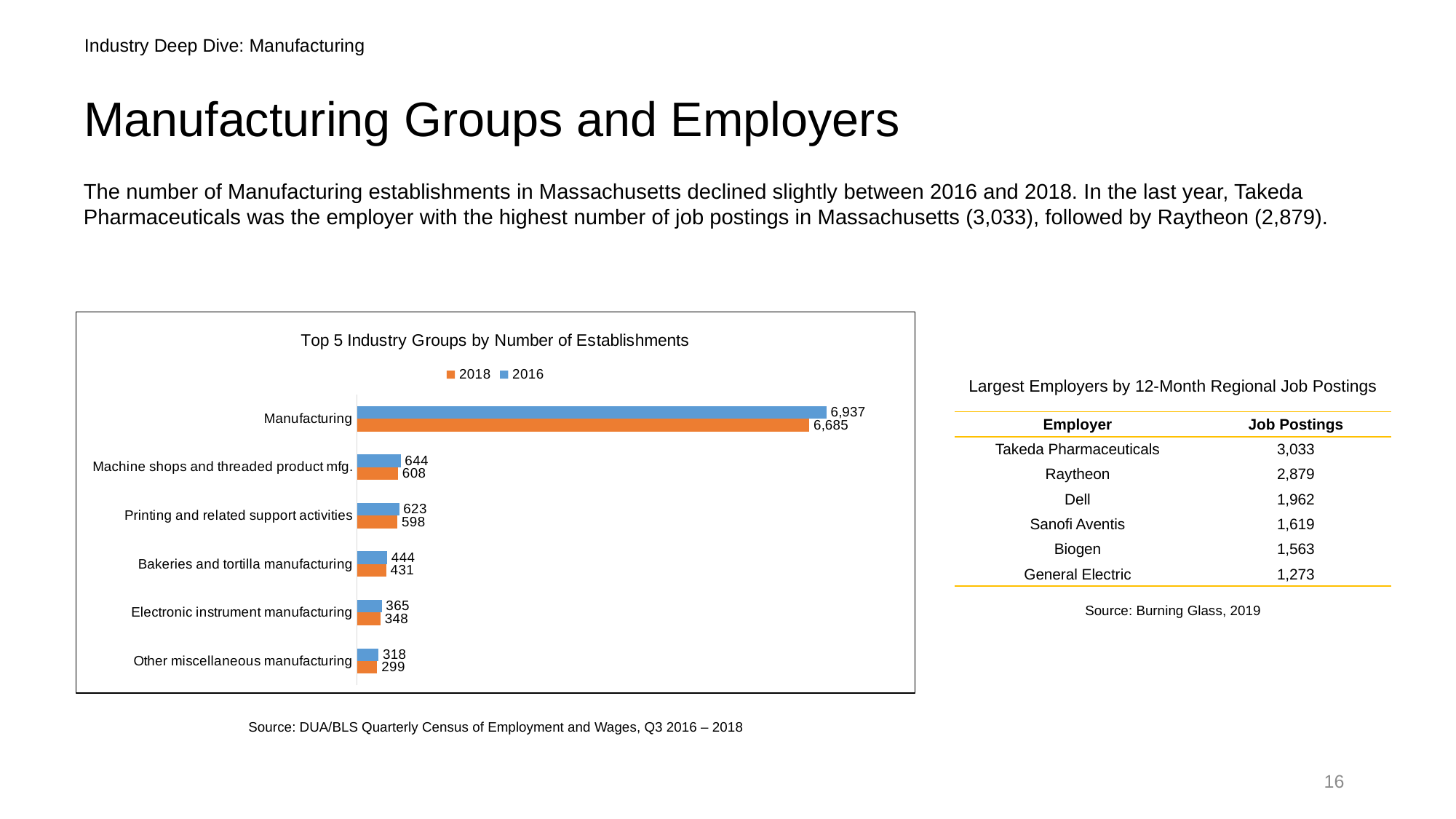
How many categories are shown in the 'Top 5 Industry Groups by Number of Establishments' chart? 6 What kind of chart is 'Top 5 Industry Groups by Number of Establishments'? bar chart In the 'Top 5 Industry Groups by Number of Establishments' chart, what is the 2016 value for Printing and related support activities? 623 In the 'Top 5 Industry Groups by Number of Establishments' chart, what is the 2018 value for Bakeries and tortilla manufacturing? 431 In the 'Top 5 Industry Groups by Number of Establishments' chart, which category has the highest 2016 value? Manufacturing In the 'Top 5 Industry Groups by Number of Establishments' chart, which colour represents the 2018 series? orange In the 'Top 5 Industry Groups by Number of Establishments' chart, is the 2016 value for Electronic instrument manufacturing larger or smaller than its 2018 value? larger In the 'Top 5 Industry Groups by Number of Establishments' chart, which category has the lowest 2018 value? Other miscellaneous manufacturing In the 'Top 5 Industry Groups by Number of Establishments' chart, what is the 2018 value for Manufacturing? 6,685 In the 'Top 5 Industry Groups by Number of Establishments' chart, what is the difference between the 2016 and 2018 values for Manufacturing? 252 In the 'Top 5 Industry Groups by Number of Establishments' chart, what is the difference between the 2016 and 2018 values for Machine shops and threaded product mfg.? 36 How many series does the legend of the 'Top 5 Industry Groups by Number of Establishments' chart list? 2